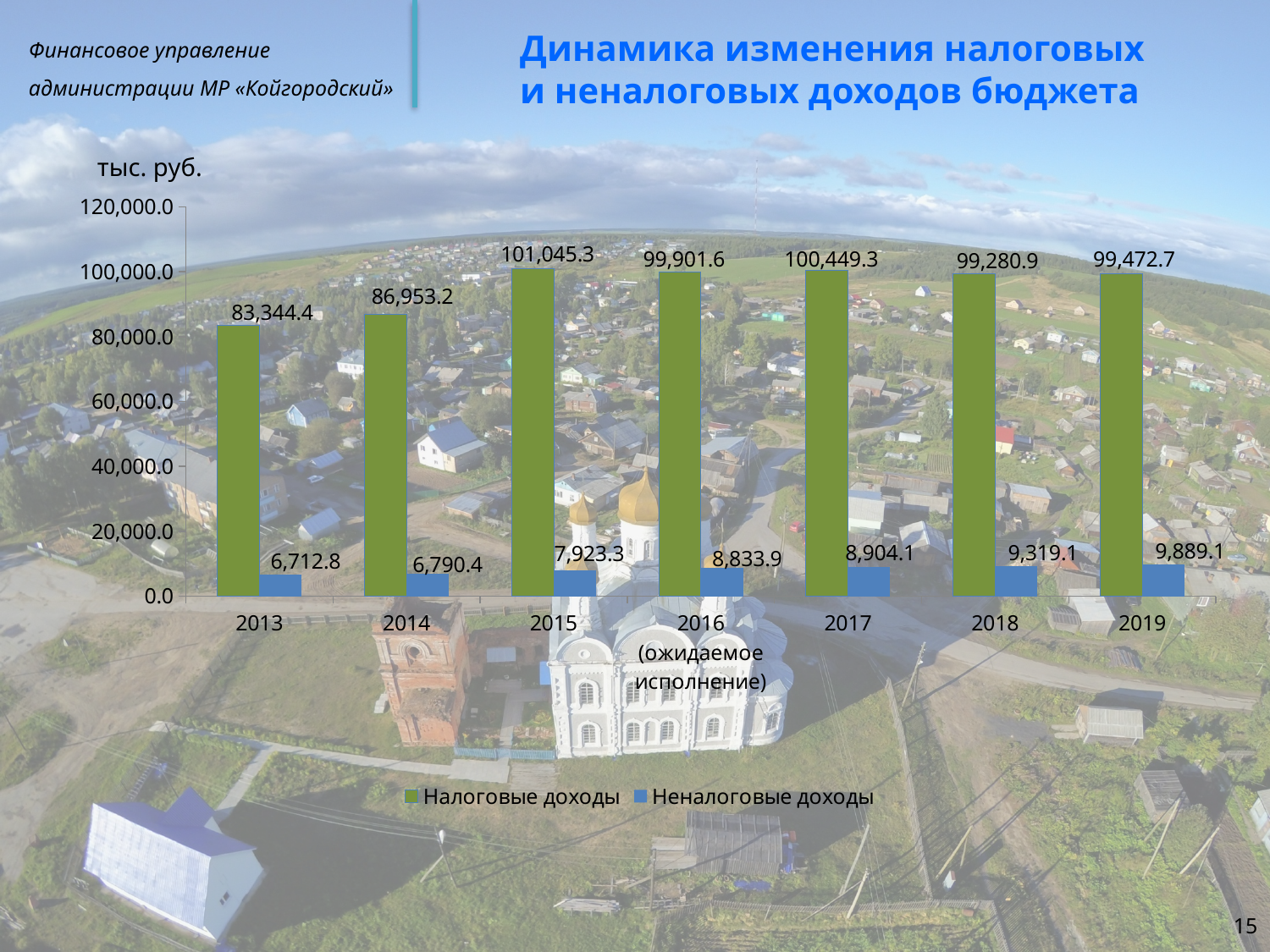
In which year are Налоговые доходы highest? 2015 What is the value of Неналоговые доходы for 2019? 9,889.1 What is the value of Налоговые доходы for 2015? 101,045.3 What is the difference between Налоговые доходы in 2015 and in 2013? 17,700.9 What kind of chart is shown on the slide? bar chart In which year are Неналоговые доходы lowest? 2013 Which is larger: Неналоговые доходы in 2016 or in 2017? 2017 What is the value of Налоговые доходы for 2013? 83,344.4 How many series does the legend list? 2 Do Неналоговые доходы rise or fall from 2013 to 2019? rise How many years are shown on the x axis? 7 Is the value of Налоговые доходы for 2014 greater or less than 80,000.0? greater